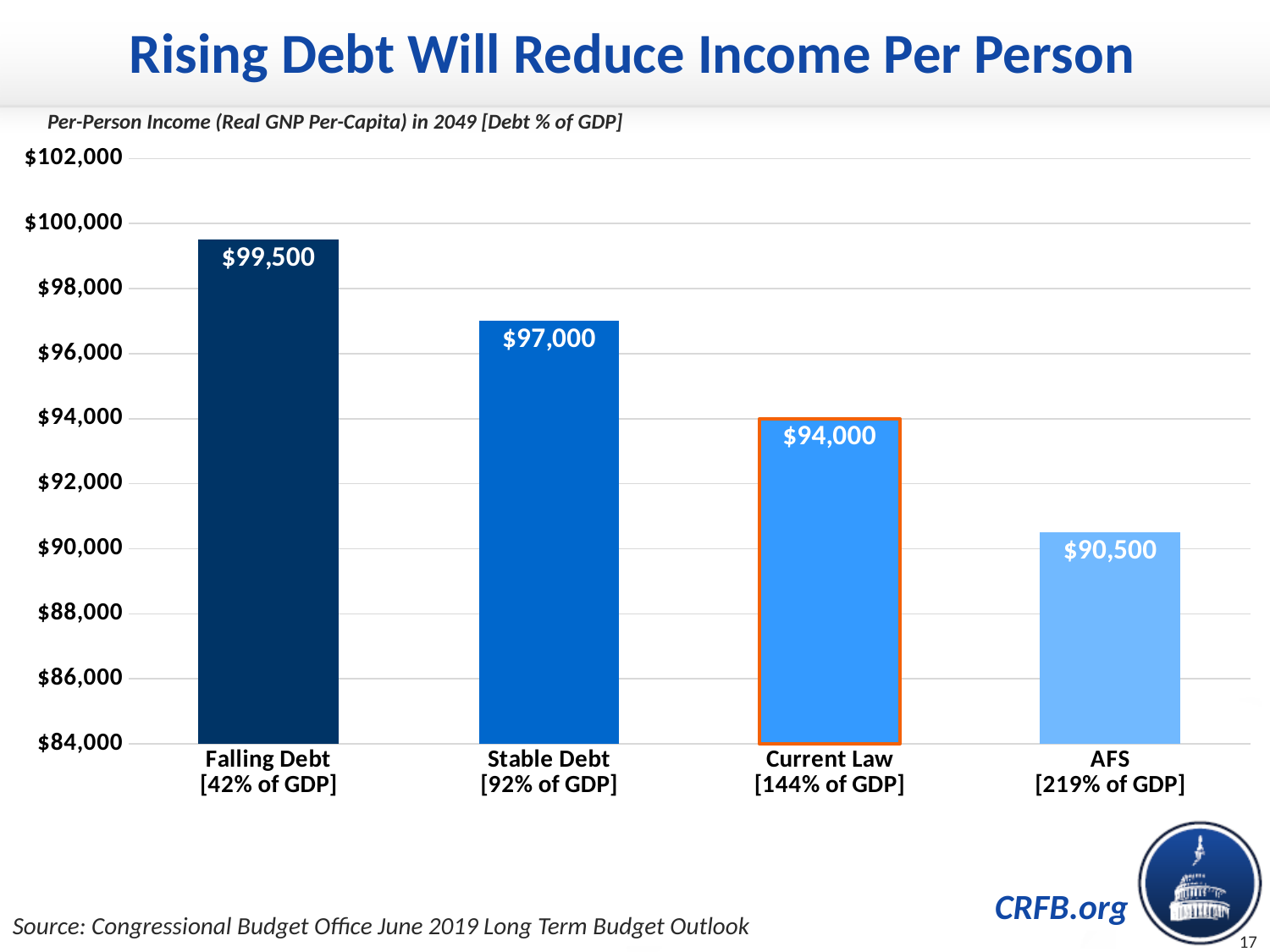
What is the difference in per-person income between Falling Debt and AFS? $9,000 Is the value for AFS greater or less than $92,000? less Which is larger, the per-person income under Stable Debt or under Current Law? Stable Debt What is the per-person income value shown for Falling Debt [42% of GDP]? $99,500 Do the per-person income values rise or fall moving from left to right across the scenarios? Fall What is the difference in per-person income between Stable Debt and Current Law? $3,000 Which scenario has the lowest per-person income in 2049? AFS [219% of GDP] How many scenarios (bars) are shown in the chart? 4 What is the per-person income value shown for Current Law [144% of GDP]? $94,000 What kind of chart is shown on the slide? Bar chart Which scenario has the highest per-person income in 2049? Falling Debt [42% of GDP] What is the per-person income value shown for AFS [219% of GDP]? $90,500